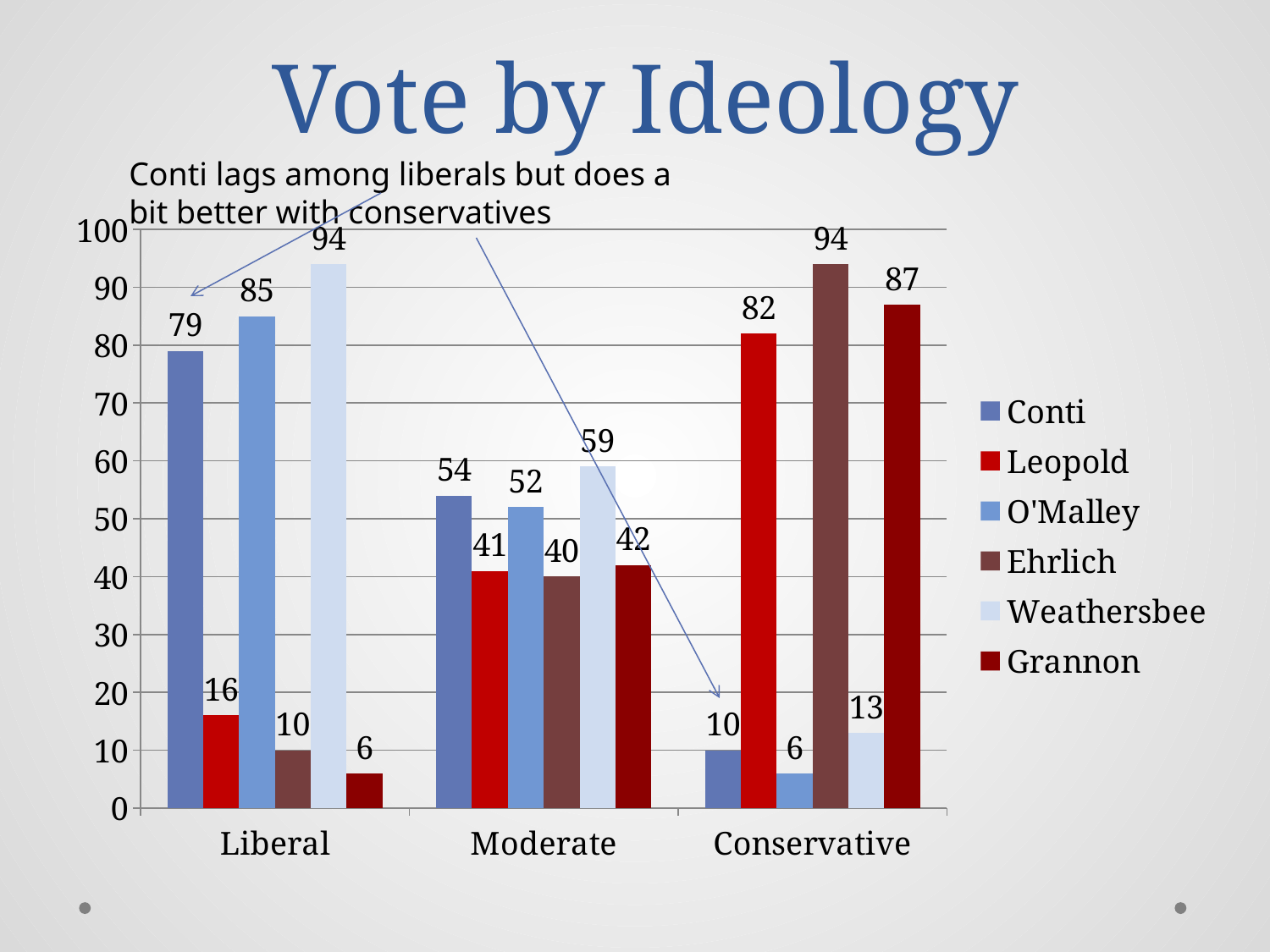
Which is larger: Conti's value among Moderates or O'Malley's value among Moderates? Conti's value among Moderates What is the difference between Leopold's value among Conservatives and among Liberals? 66 What is the value for Ehrlich among Conservative voters? 94 How many series does the legend list? 6 What kind of chart is shown on the slide? Bar chart Which series has the highest value in the Liberal category? Weathersbee How many ideology categories are shown on the x axis? 3 Do Grannon's values rise or fall from Liberal to Conservative? Rise Which series has the lowest value in the Conservative category? O'Malley What is the value for Conti among Liberal voters? 79 What is the value for Weathersbee among Moderate voters? 59 What is the title of the chart? Vote by Ideology